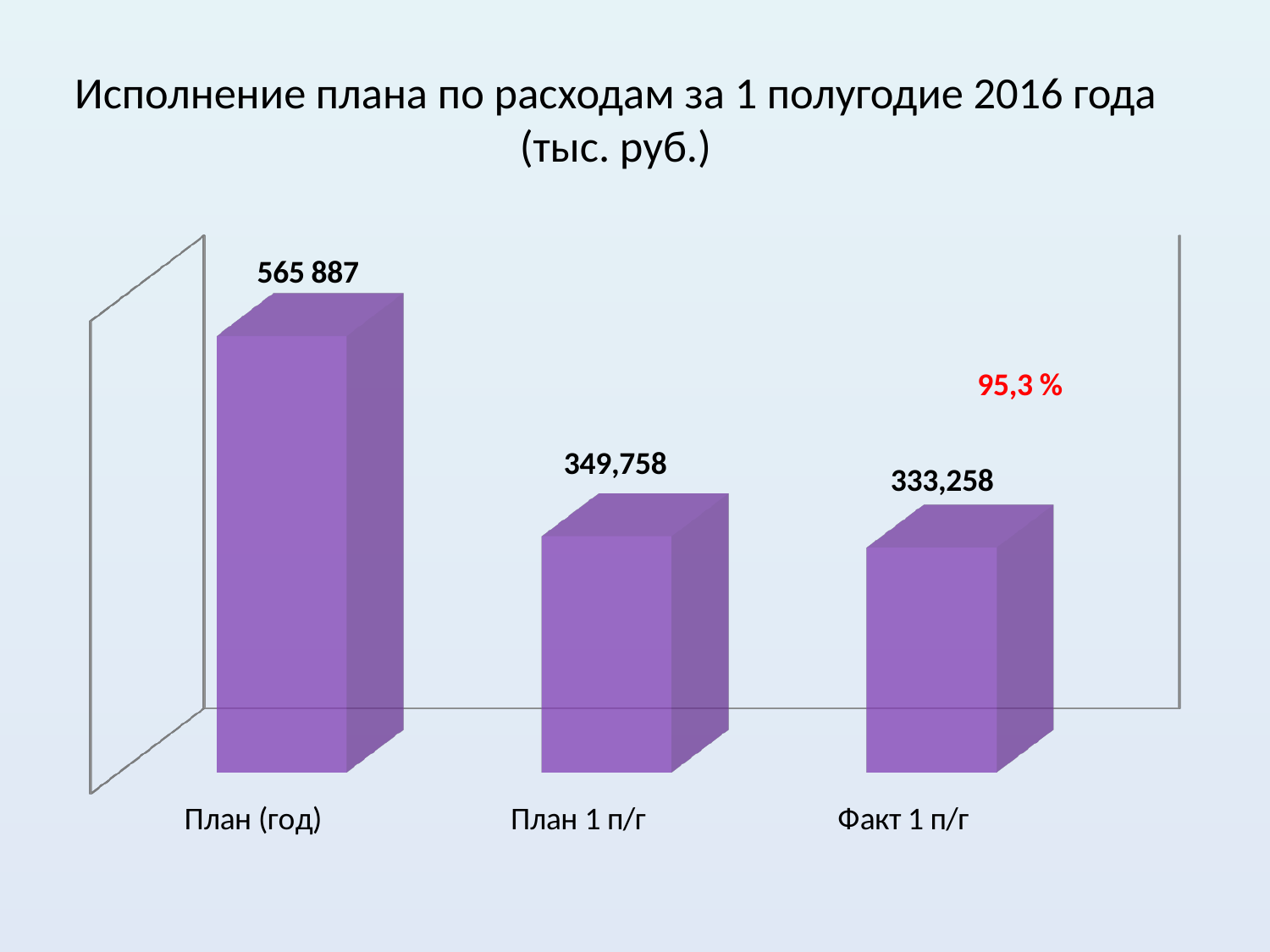
What kind of chart is shown on the slide? Bar chart What is the value shown for План 1 п/г? 349,758 Do the values rise or fall from left to right across the categories? Fall What percentage is shown in red on the chart? 95,3 % Which is larger, the value for План 1 п/г or the value for Факт 1 п/г? План 1 п/г Which category has the lowest value? Факт 1 п/г What is the difference between the values for План 1 п/г and Факт 1 п/г? 16,500 What unit is given in the chart title? тыс. руб. What is the value shown for План (год)? 565 887 What is the value shown for Факт 1 п/г? 333,258 Which category has the highest value? План (год) How many bars are shown in the chart? 3